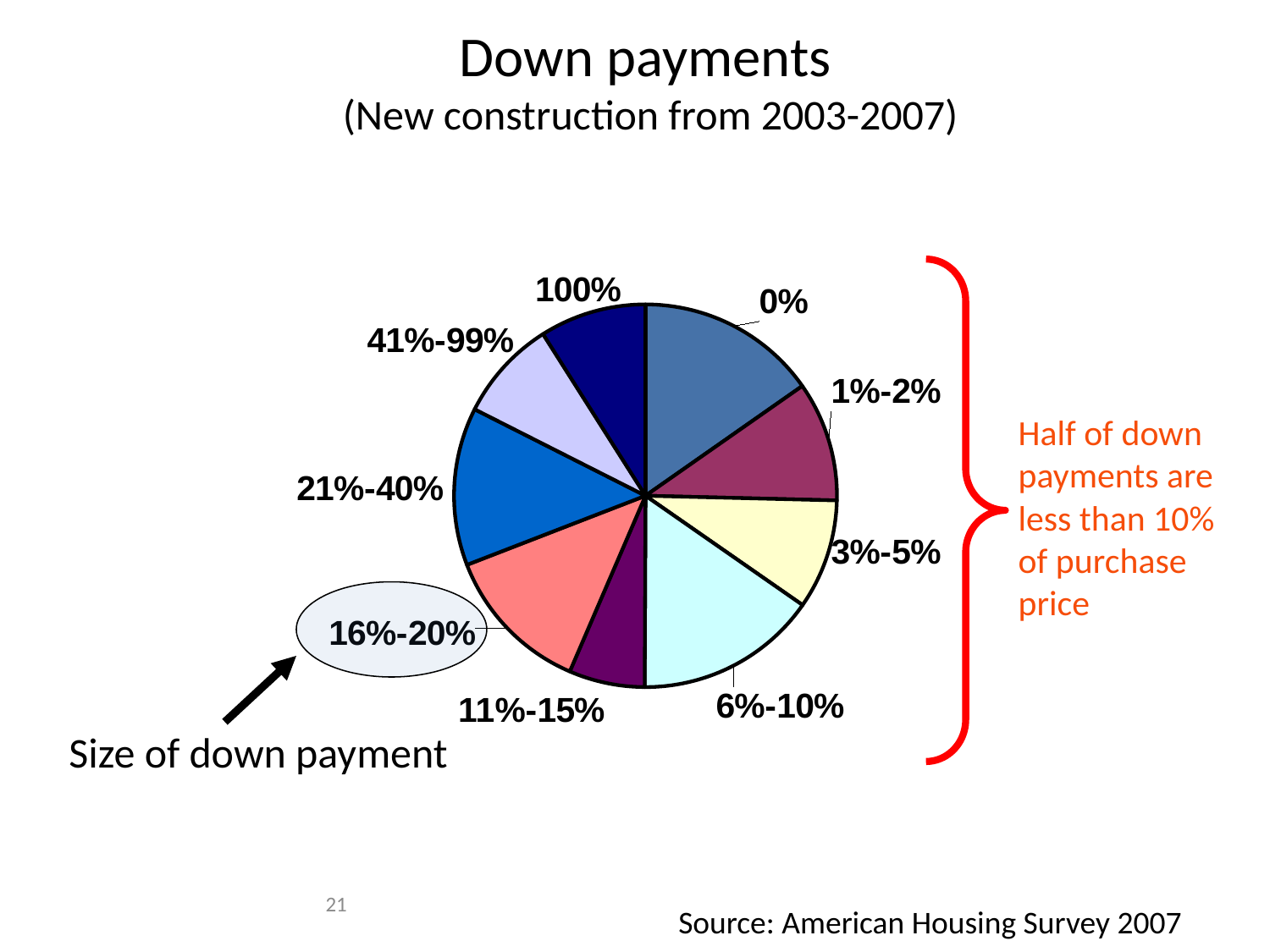
What kind of chart is shown on the slide? pie chart What is the title of the chart on the slide? Down payments (New construction from 2003-2007) How many slices does the pie chart have? 9 Which slice is larger, 6%-10% or 1%-2%? 6%-10% Which slice is larger, 0% or 100%? 0% Which slice is larger, 21%-40% or 41%-99%? 21%-40% Which slice label is highlighted with an oval and an arrow labelled "Size of down payment"? 16%-20% Which slice of the pie chart is the smallest? 11%-15%